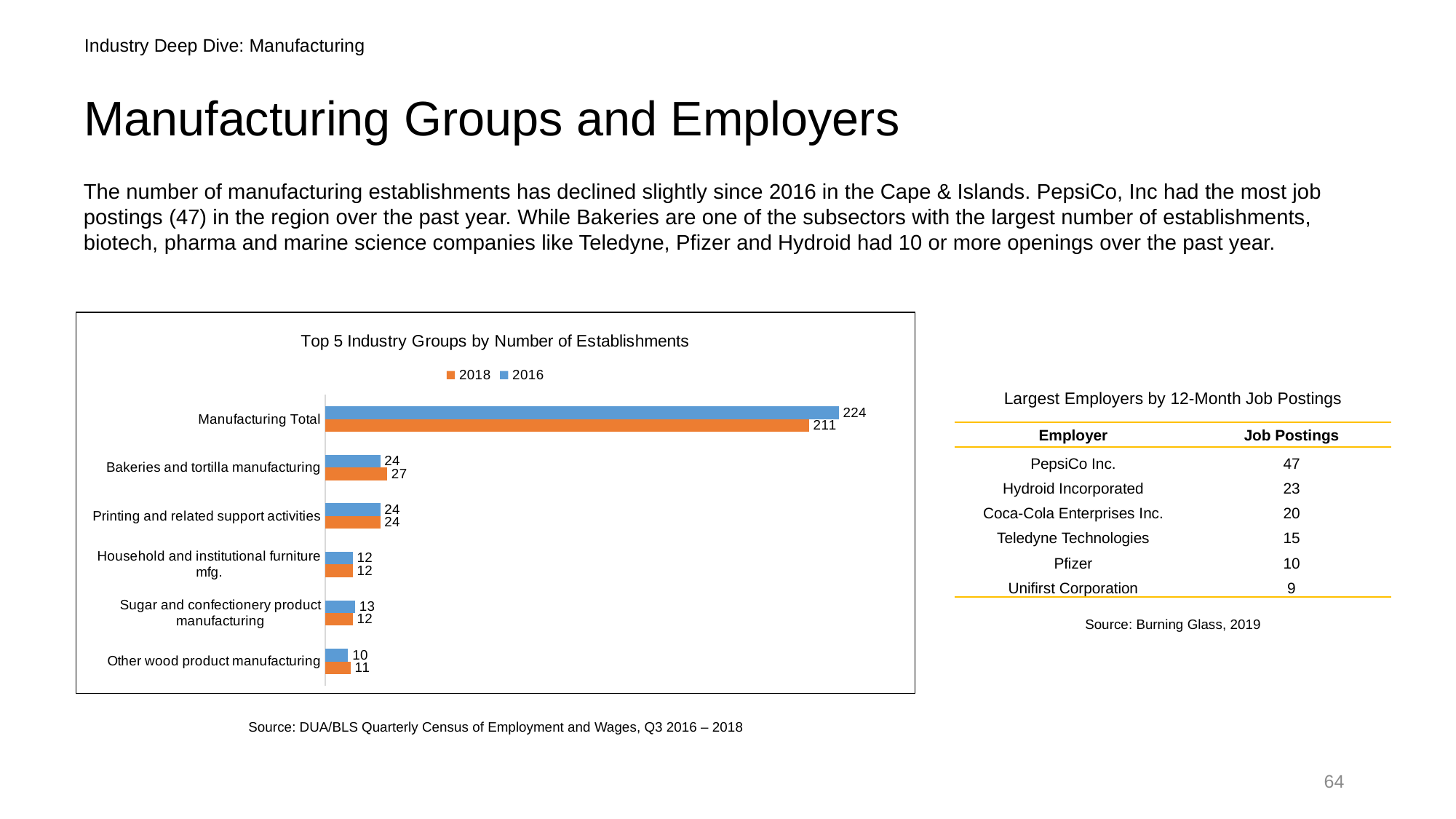
What is the 2018 value for Bakeries and tortilla manufacturing? 27 How many series does the legend of the chart list? 2 What is the 2018 value for Manufacturing Total? 211 Which colour represents the 2018 series in the chart? Orange What is the difference between the 2016 and 2018 values for Manufacturing Total? 13 Which is larger for Bakeries and tortilla manufacturing, the 2018 value or the 2016 value? 2018 What is the 2016 value for Manufacturing Total? 224 What is the 2016 value for Sugar and confectionery product manufacturing? 13 What type of chart is "Top 5 Industry Groups by Number of Establishments"? Bar chart Excluding Manufacturing Total, which category has the lowest 2016 value? Other wood product manufacturing What is the 2018 value for Other wood product manufacturing? 11 How many categories are shown on the chart's vertical axis? 6